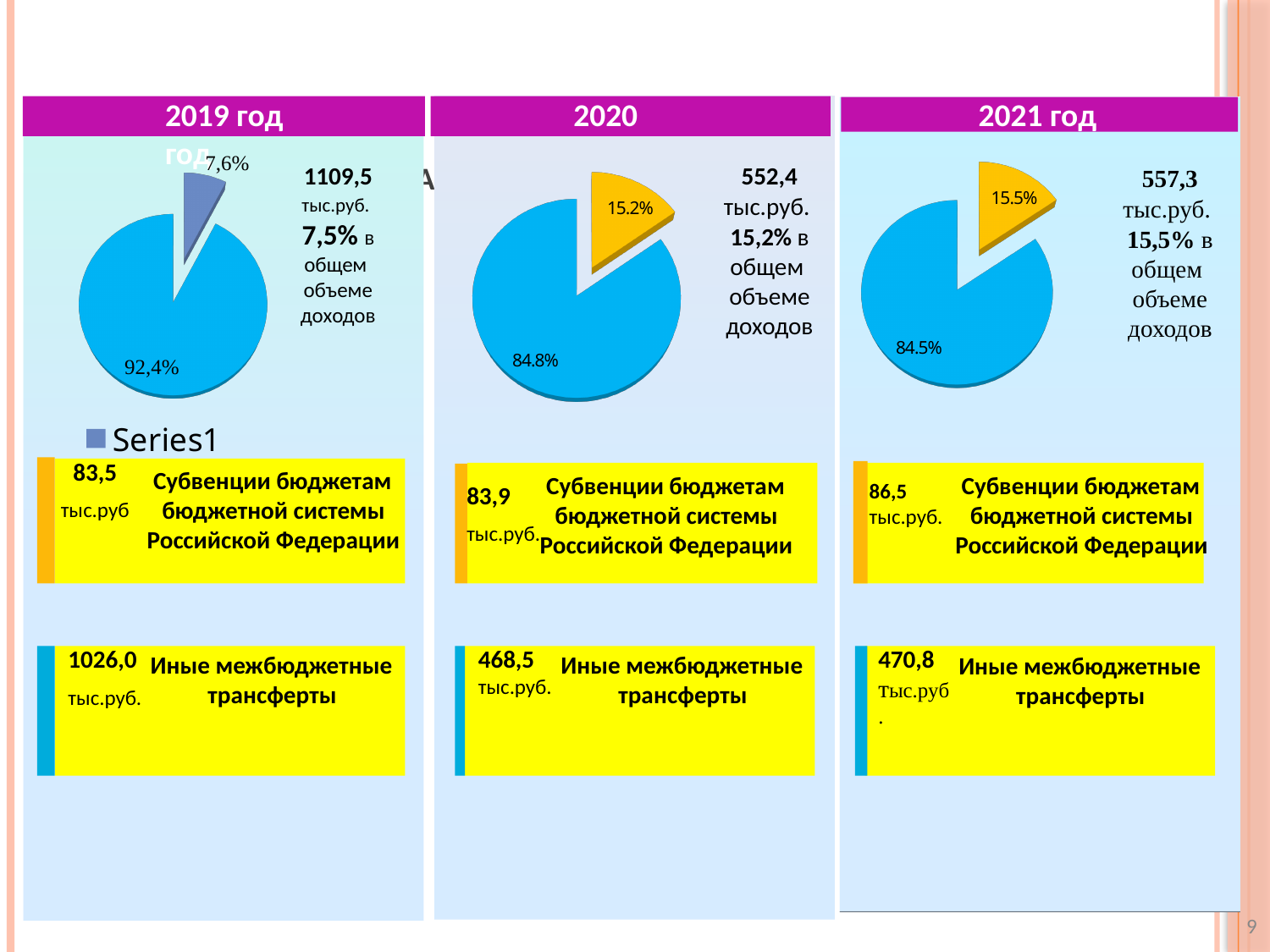
In the 2019 год pie chart, what is the value shown for the larger slice? 92,4% In the 2020 pie chart, what is the value shown for the larger slice? 84.8% What kind of chart is used under the 2020 heading? Pie chart How many series does the legend of the 2019 год pie chart list? 1 In the 2020 pie chart, what is the value shown for the smaller slice? 15.2% How many slices does the 2021 год pie chart have? 2 In the 2021 год pie chart, what is the value shown for the smaller slice? 15.5% In the 2021 год pie chart, what colour is the smaller slice? Yellow In the 2019 год pie chart, what is the value shown for the smaller slice? 7,6% In the 2021 год pie chart, what is the value shown for the larger slice? 84.5% What is the legend entry shown under the 2019 год pie chart? Series1 In the 2019 год pie chart, what is the difference between the larger slice and the smaller slice? 84,8 percentage points